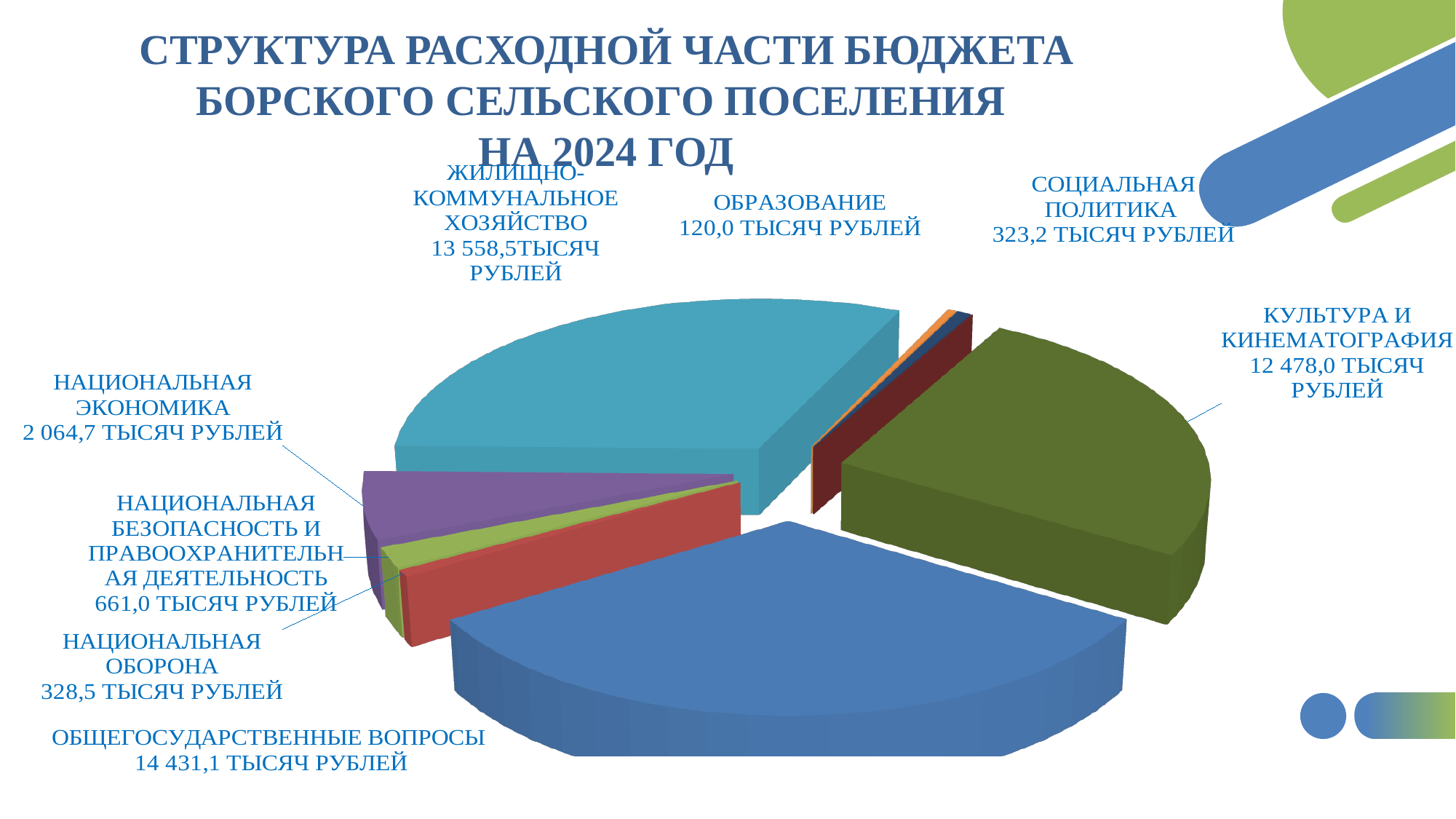
Which category has the largest value in the pie chart? ОБЩЕГОСУДАРСТВЕННЫЕ ВОПРОСЫ What is the difference between ОБЩЕГОСУДАРСТВЕННЫЕ ВОПРОСЫ and ЖИЛИЩНО-КОММУНАЛЬНОЕ ХОЗЯЙСТВО? 872,6 тысяч рублей Which category has the smallest value in the pie chart? ОБРАЗОВАНИЕ What is the value for ЖИЛИЩНО-КОММУНАЛЬНОЕ ХОЗЯЙСТВО? 13 558,5 тысяч рублей What is the difference between НАЦИОНАЛЬНАЯ БЕЗОПАСНОСТЬ И ПРАВООХРАНИТЕЛЬНАЯ ДЕЯТЕЛЬНОСТЬ and НАЦИОНАЛЬНАЯ ОБОРОНА? 332,5 тысяч рублей What is the value for КУЛЬТУРА И КИНЕМАТОГРАФИЯ? 12 478,0 тысяч рублей How many categories (slices) does the pie chart have? 9 What year does the chart title say the budget structure is for? 2024 What kind of chart is shown on the slide? Pie chart Which is larger, НАЦИОНАЛЬНАЯ ОБОРОНА or СОЦИАЛЬНАЯ ПОЛИТИКА? НАЦИОНАЛЬНАЯ ОБОРОНА What is the value for НАЦИОНАЛЬНАЯ ЭКОНОМИКА? 2 064,7 тысяч рублей What is the value for ОБЩЕГОСУДАРСТВЕННЫЕ ВОПРОСЫ? 14 431,1 тысяч рублей